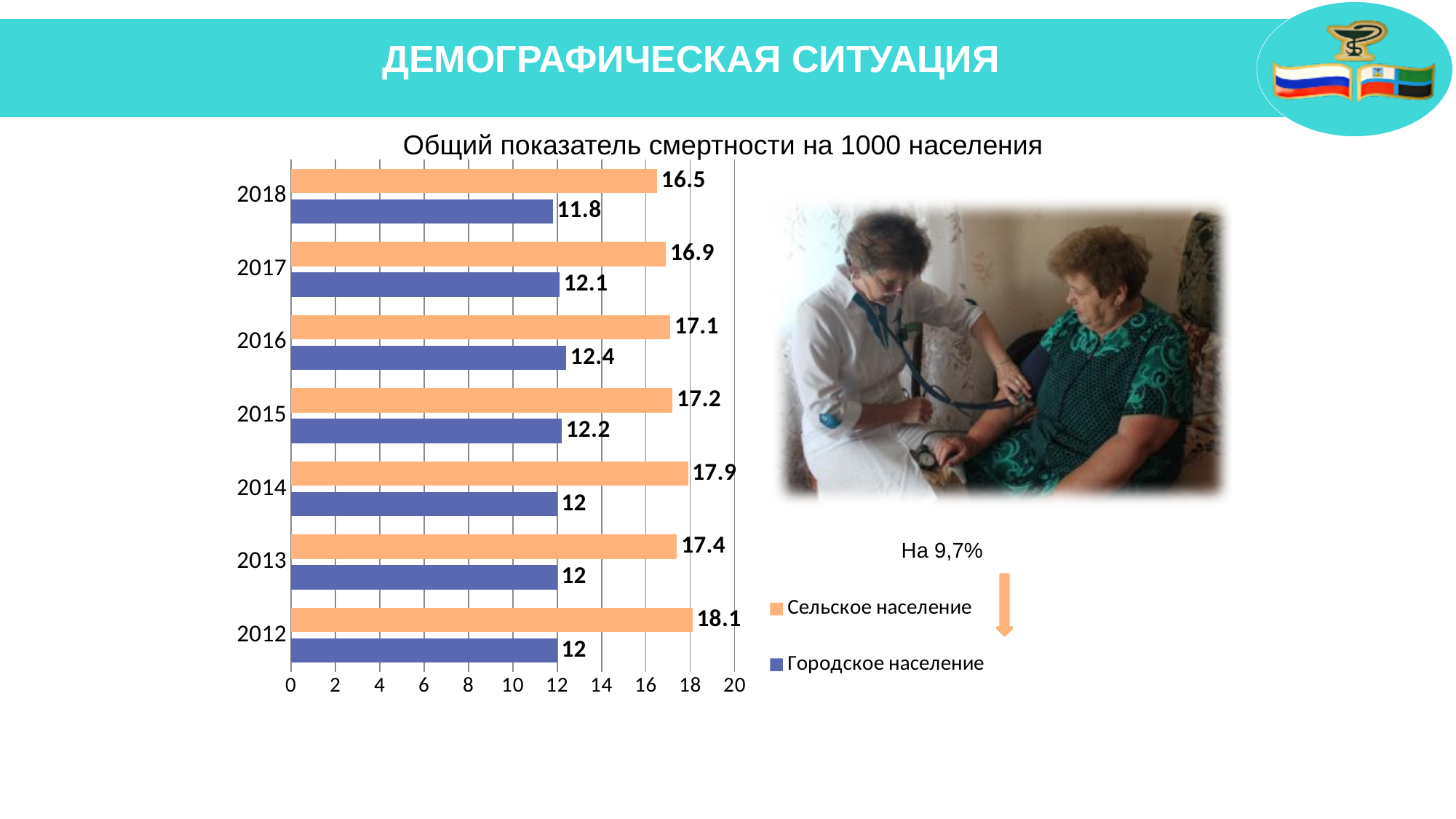
What kind of chart is shown on the slide? bar chart What is the title of the chart? Общий показатель смертности на 1000 населения How many series does the legend list? 2 How many years are shown on the chart? 7 Is the value for Сельское население in 2013 greater or less than 16? greater Which is larger in 2017: the value for Сельское население or for Городское население? Сельское население What is the value for Городское население in 2016? 12.4 What is the difference between the Сельское население and Городское население values in 2014? 5.9 What is the value for Сельское население in 2018? 16.5 Which year has the lowest value for Городское население? 2018 Which year has the highest value for Сельское население? 2012 Does the value for Сельское население rise or fall from 2012 to 2018? fall